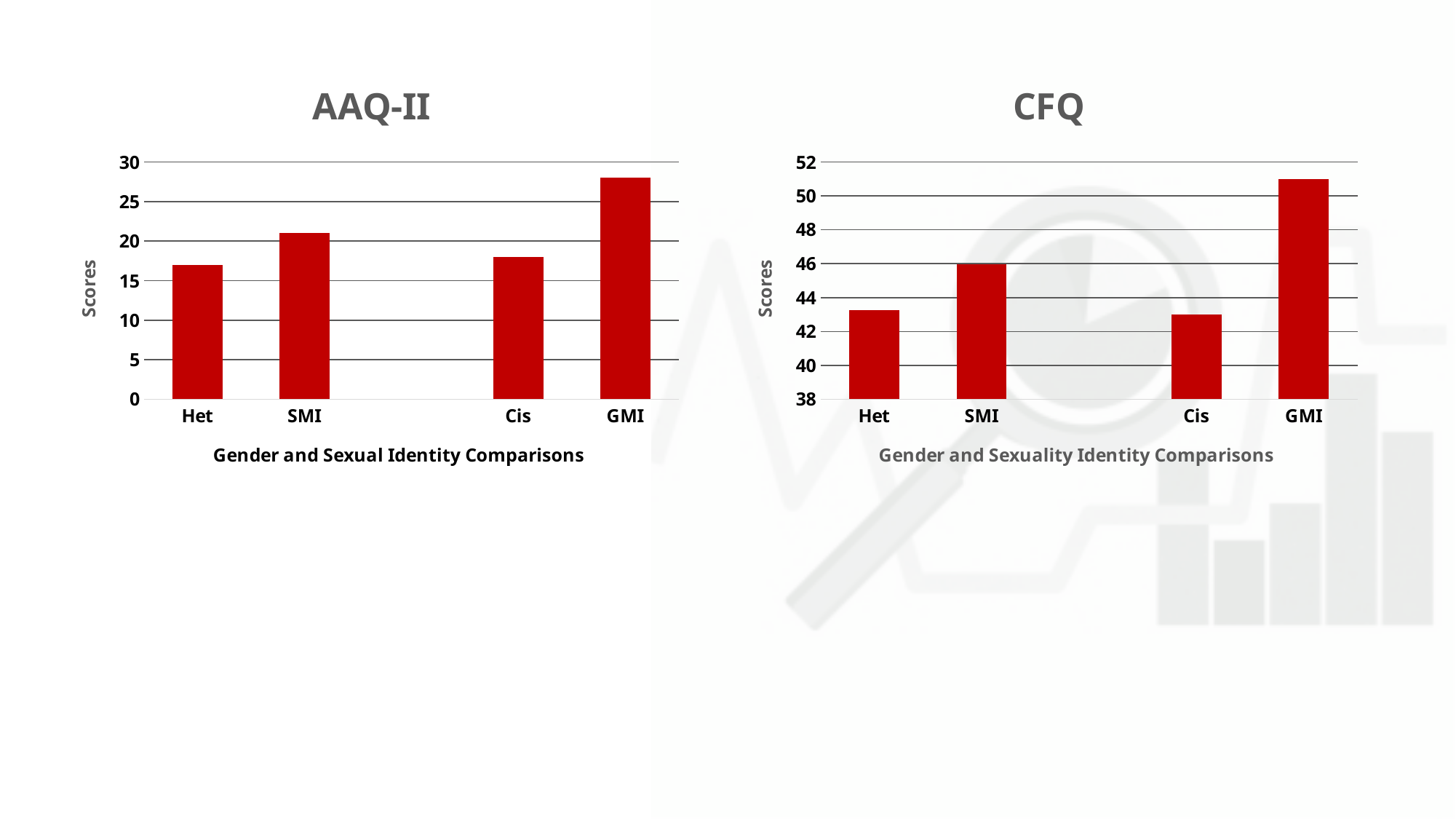
On the CFQ chart, is the value for Het greater or less than 44? less On the CFQ chart, which is larger, the value for SMI or the value for Het? SMI On the AAQ-II chart, which is larger, the value for SMI or the value for Cis? SMI What kind of chart is the AAQ-II chart? bar chart On the CFQ chart, is the value for GMI greater or less than 50? greater On the AAQ-II chart, is the value for Cis greater or less than 20? less On the AAQ-II chart, which category has the highest score? GMI What is the x-axis label of the AAQ-II chart? Gender and Sexual Identity Comparisons How many categories are shown on the CFQ chart? 4 On the CFQ chart, which category has the highest score? GMI